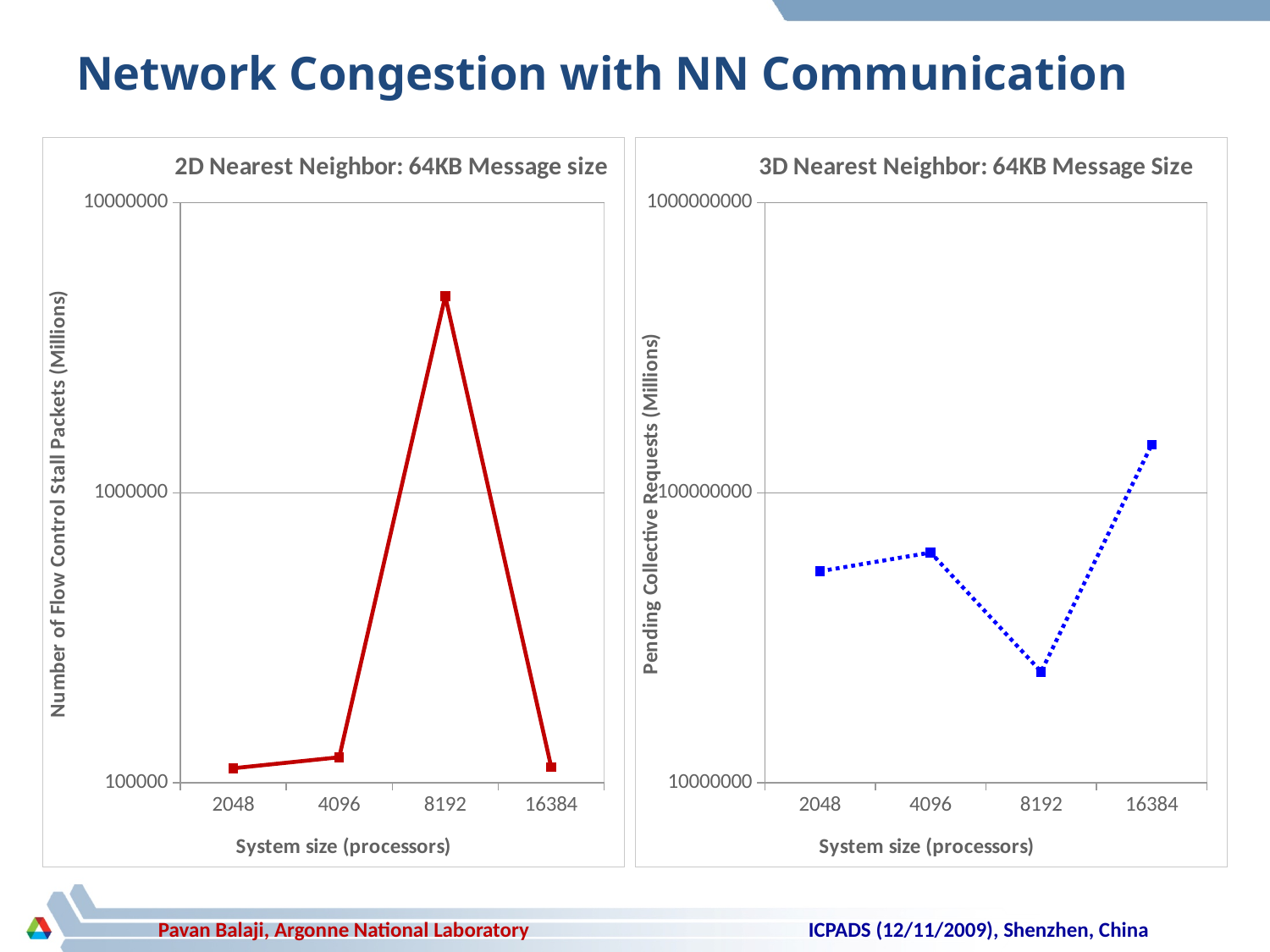
In the chart titled "3D Nearest Neighbor: 64KB Message Size", which is larger, the value for 4096 processors or the value for 8192 processors? 4096 In the chart titled "2D Nearest Neighbor: 64KB Message size", which system size has the highest number of flow control stall packets? 8192 In the chart titled "3D Nearest Neighbor: 64KB Message Size", is the value for 8192 processors greater or less than 100000000? less How many system sizes are plotted on the x axis of the chart titled "2D Nearest Neighbor: 64KB Message size"? 4 What kind of chart is the chart titled "3D Nearest Neighbor: 64KB Message Size"? Line chart What is the y-axis title of the chart titled "3D Nearest Neighbor: 64KB Message Size"? Pending Collective Requests (Millions) In the chart titled "2D Nearest Neighbor: 64KB Message size", which is larger, the value for 4096 processors or the value for 8192 processors? 8192 In the chart titled "3D Nearest Neighbor: 64KB Message Size", which system size has the lowest number of pending collective requests? 8192 In the chart titled "3D Nearest Neighbor: 64KB Message Size", which system size has the highest number of pending collective requests? 16384 In the chart titled "2D Nearest Neighbor: 64KB Message size", is the value for 8192 processors greater or less than 1000000? greater In the chart titled "3D Nearest Neighbor: 64KB Message Size", is the value for 16384 processors greater or less than 100000000? greater